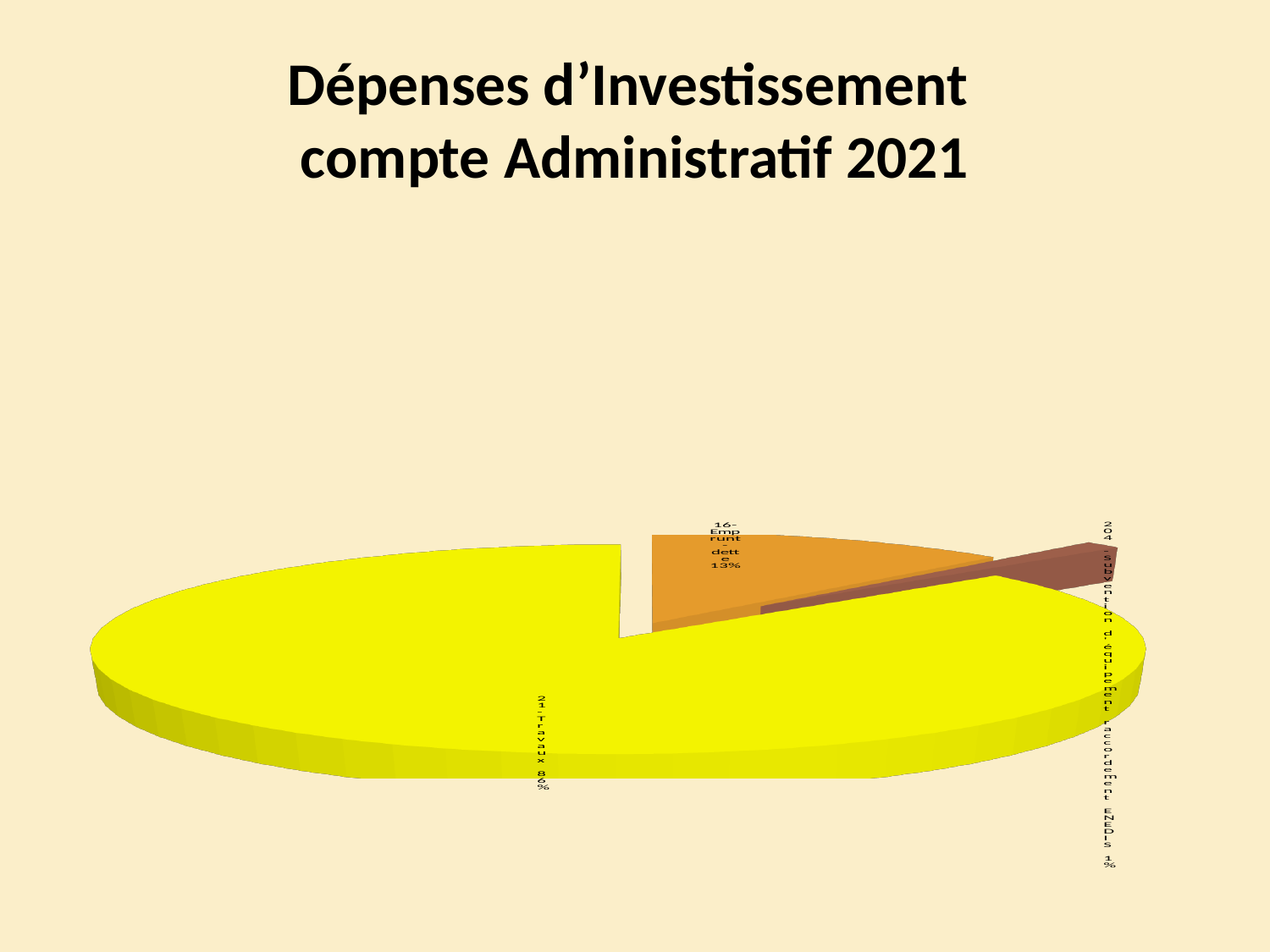
What is the title of the slide containing the pie chart? Dépenses d'Investissement compte Administratif 2021 How many slices does the pie chart have? 3 Which category has the smallest share of the pie? 204-Subvention d'équipement raccordement ENEDIS Which category has the largest share of the pie? 21-Travaux What share of the pie does the "16-Emprunt dette" slice represent? 13% What share of the pie does the "21-Travaux" slice represent? 86% Which is larger, the share for "16-Emprunt dette" or the share for "204-Subvention d'équipement raccordement ENEDIS"? 16-Emprunt dette What is the difference in percentage points between the "21-Travaux" share and the "16-Emprunt dette" share? 73 What colour is the "21-Travaux" slice of the pie chart? yellow What is the combined share of the "16-Emprunt dette" and "204-Subvention d'équipement raccordement ENEDIS" slices? 14% What kind of chart is shown on the slide? pie chart What share of the pie does the "204-Subvention d'équipement raccordement ENEDIS" slice represent? 1%